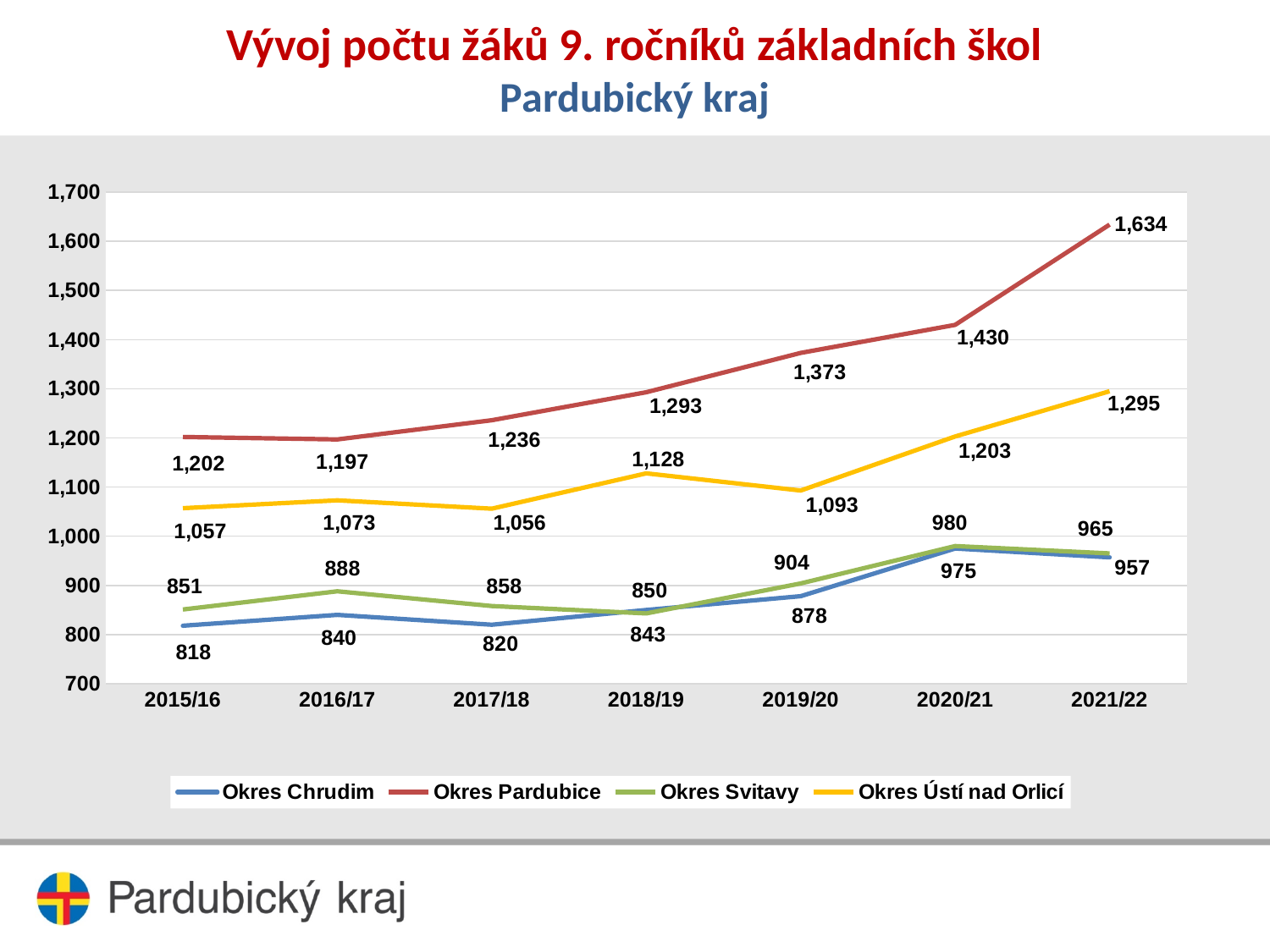
In which school year did Okres Chrudim have its lowest value? 2015/16 How many series does the legend list? 4 What is the difference between the Okres Ústí nad Orlicí values in 2021/22 and 2015/16? 238 In 2020/21, which had the higher value: Okres Svitavy or Okres Chrudim? Okres Svitavy How many school years are shown on the x axis? 7 What was the value for Okres Chrudim in 2015/16? 818 In which school year did Okres Pardubice reach its highest value? 2021/22 What was the value for Okres Ústí nad Orlicí in 2019/20? 1,093 What was the value for Okres Svitavy in 2016/17? 888 What was the number of pupils for Okres Pardubice in 2021/22? 1,634 What kind of chart is shown on the slide? Line chart By how much did the value for Okres Pardubice increase from 2020/21 to 2021/22? 204